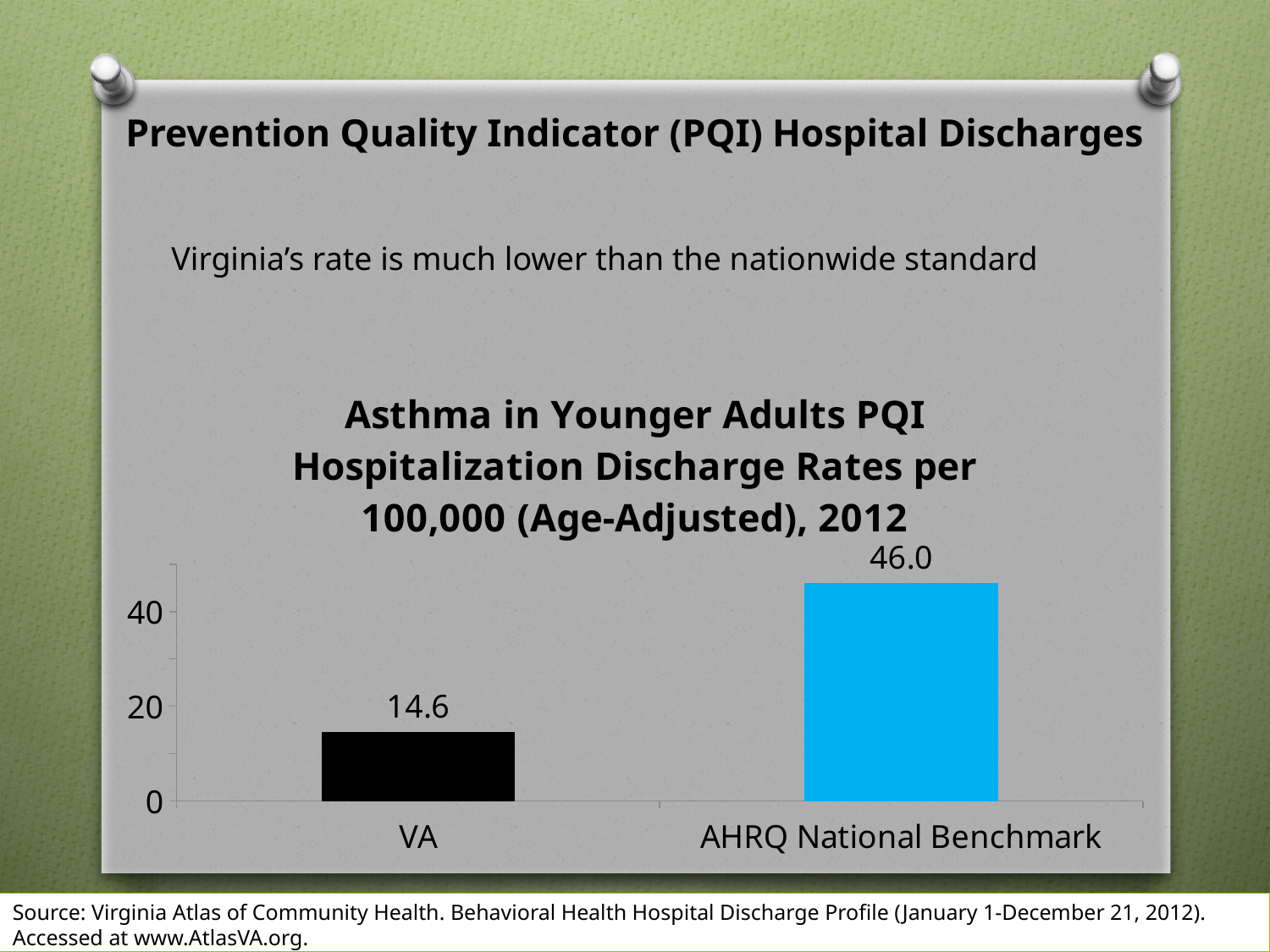
Which is larger, the value for VA or the value for AHRQ National Benchmark? AHRQ National Benchmark What is the value for AHRQ National Benchmark? 46.0 Is the value for AHRQ National Benchmark greater or less than 40? greater What is the value for VA? 14.6 Which category has the highest value? AHRQ National Benchmark How many categories are shown in the chart? 2 What is the difference between the AHRQ National Benchmark value and the VA value? 31.4 What colour is the bar for AHRQ National Benchmark? Blue What is the title of the chart? Asthma in Younger Adults PQI Hospitalization Discharge Rates per 100,000 (Age-Adjusted), 2012 Is the value for VA greater or less than 20? less What kind of chart is shown on the slide? Bar chart Which category has the lowest value? VA